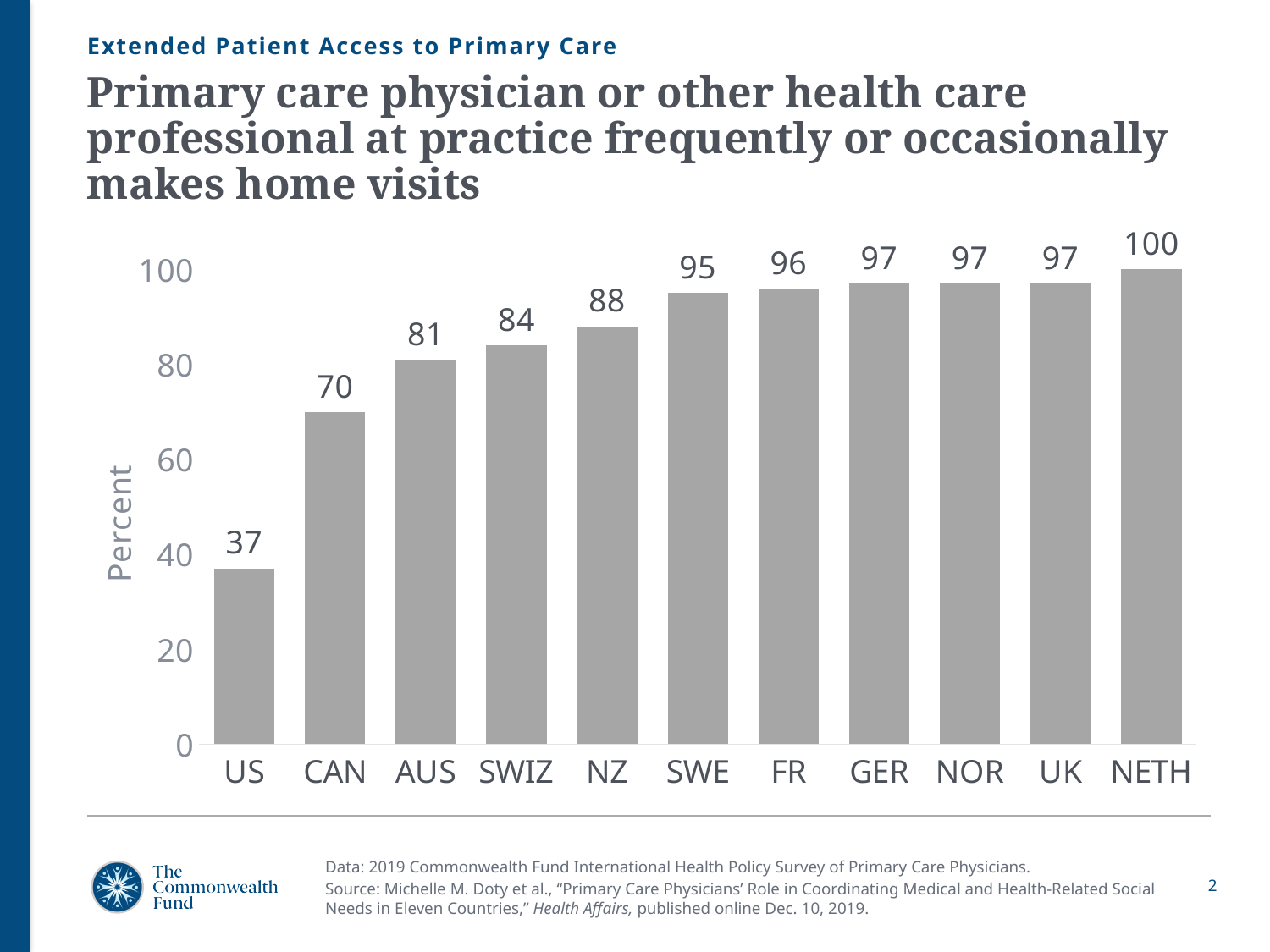
Which country has the highest value? NETH Which is larger, the value for SWE or the value for NZ? SWE What kind of chart is shown on the slide? Bar chart Is the value for CAN greater or less than 60? greater What is the difference between the values for CAN and AUS? 11 How many countries are shown on the chart? 11 What is the value for the US? 37 What is the value for NZ? 88 What is the label on the vertical axis? Percent What is the value for SWIZ? 84 Which country has the lowest value? US What is the difference between the values for NETH and the US? 63